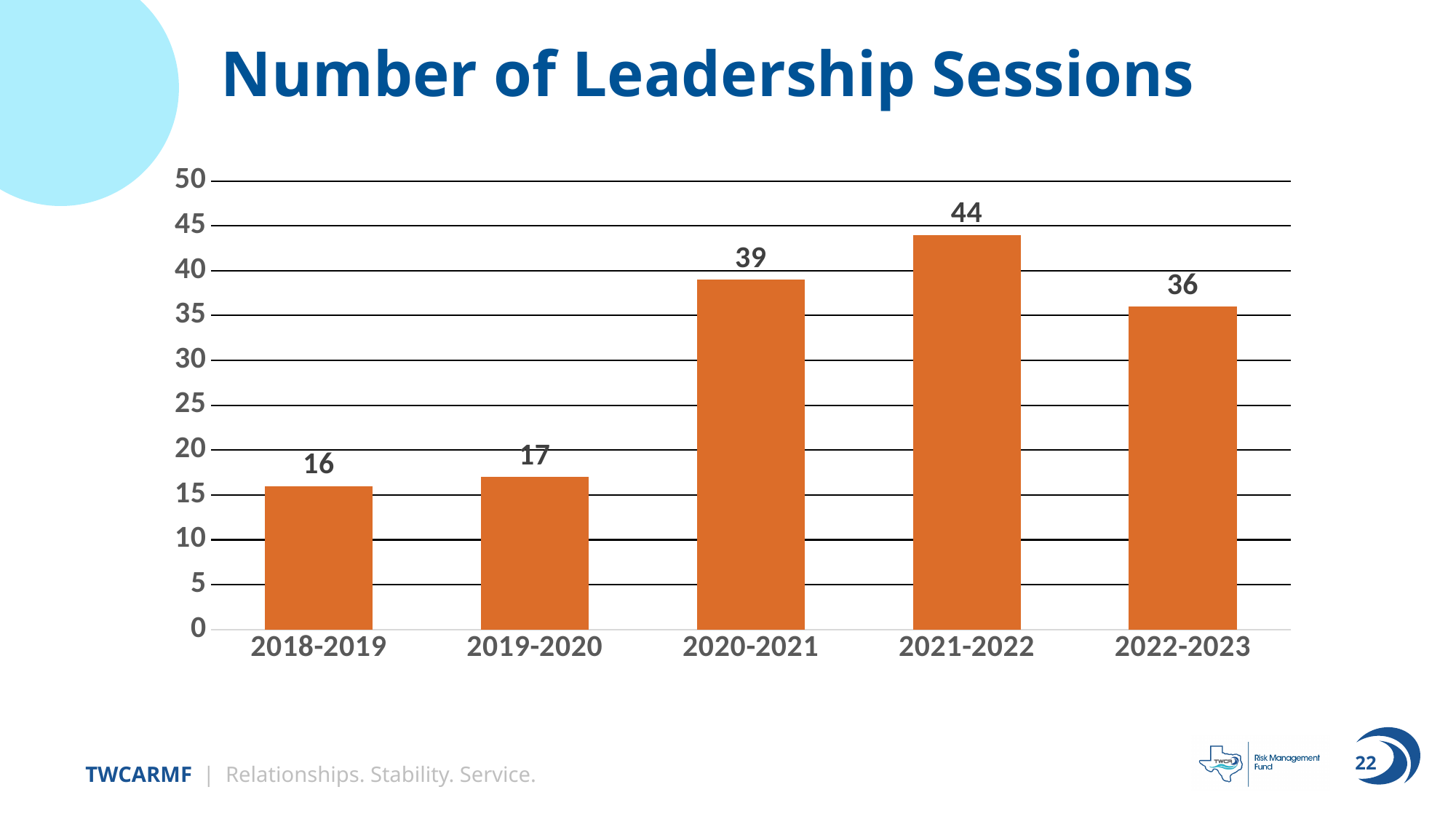
What is the title of the chart? Number of Leadership Sessions Which year had the highest number of leadership sessions? 2021-2022 How many more sessions were held in 2020-2021 than in 2019-2020? 22 Is the value for 2021-2022 greater or less than 40? greater What is the value shown for 2022-2023? 36 What kind of chart is shown on the slide? Bar chart Which had more leadership sessions, 2019-2020 or 2022-2023? 2022-2023 How many leadership sessions were held in 2018-2019? 16 Which year had the lowest number of leadership sessions? 2018-2019 How many year categories are shown on the x axis? 5 What is the value shown for 2020-2021? 39 What is the difference between the number of sessions in 2021-2022 and 2022-2023? 8